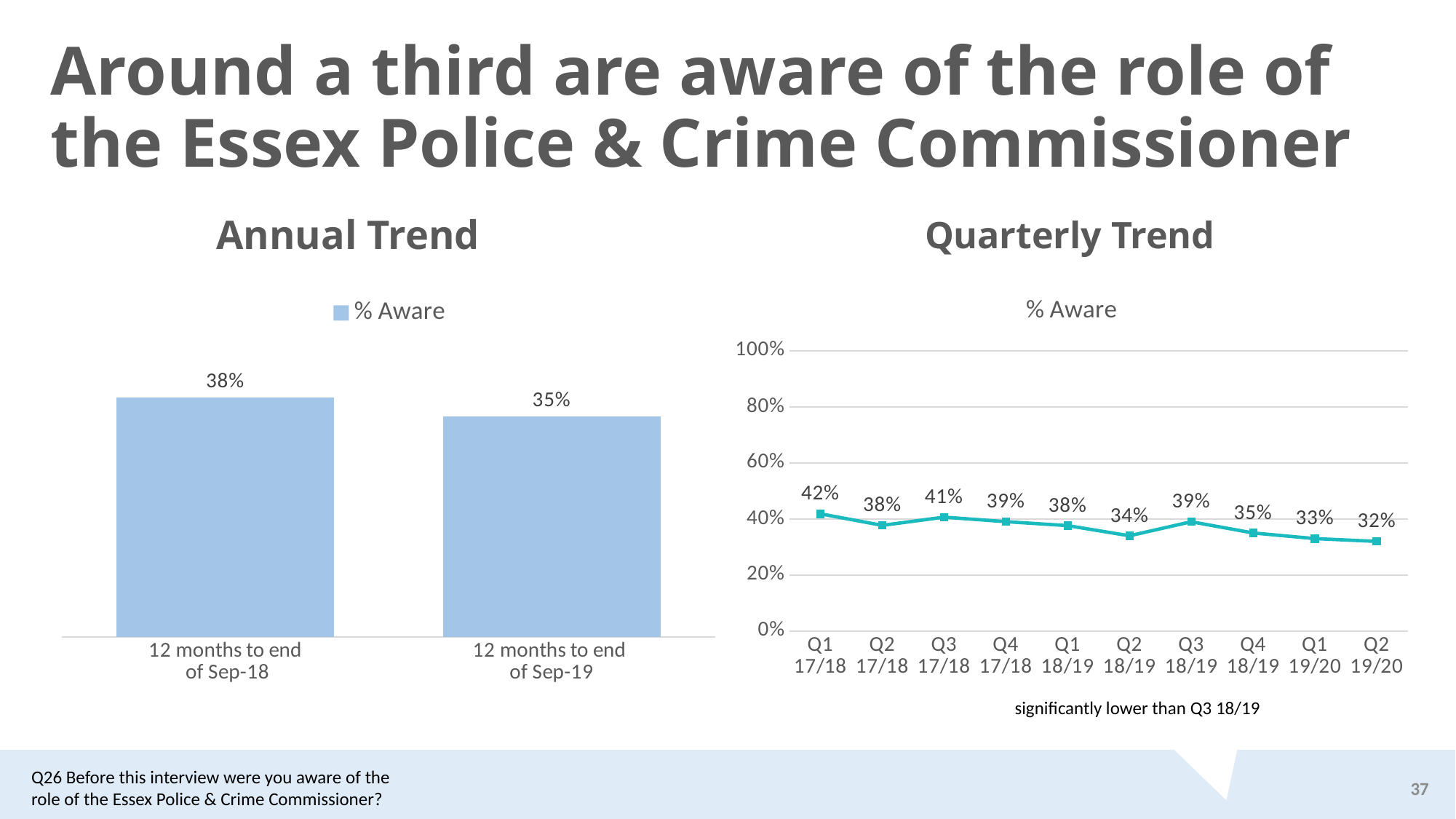
In the Quarterly Trend chart, which quarter has the lowest % Aware? Q2 19/20 In the Annual Trend chart, what is the % Aware for the 12 months to end of Sep-19? 35% In the Quarterly Trend chart, what is the % Aware for Q3 18/19? 39% In the Quarterly Trend chart, what is the overall trend in % Aware from Q1 17/18 to Q2 19/20? Falling In the Quarterly Trend chart, how many quarters are plotted? 10 What kind of chart is the Quarterly Trend chart? Line chart In the Annual Trend chart, what is the % Aware for the 12 months to end of Sep-18? 38% In the Annual Trend chart, what is the difference in % Aware between the 12 months to end of Sep-18 and the 12 months to end of Sep-19? 3 percentage points What kind of chart is the Annual Trend chart? Bar chart In the Quarterly Trend chart, which quarter has the highest % Aware? Q1 17/18 In the Quarterly Trend chart, what is the % Aware for Q2 19/20? 32% In the Quarterly Trend chart, is the % Aware for Q2 18/19 or Q3 18/19 larger? Q3 18/19